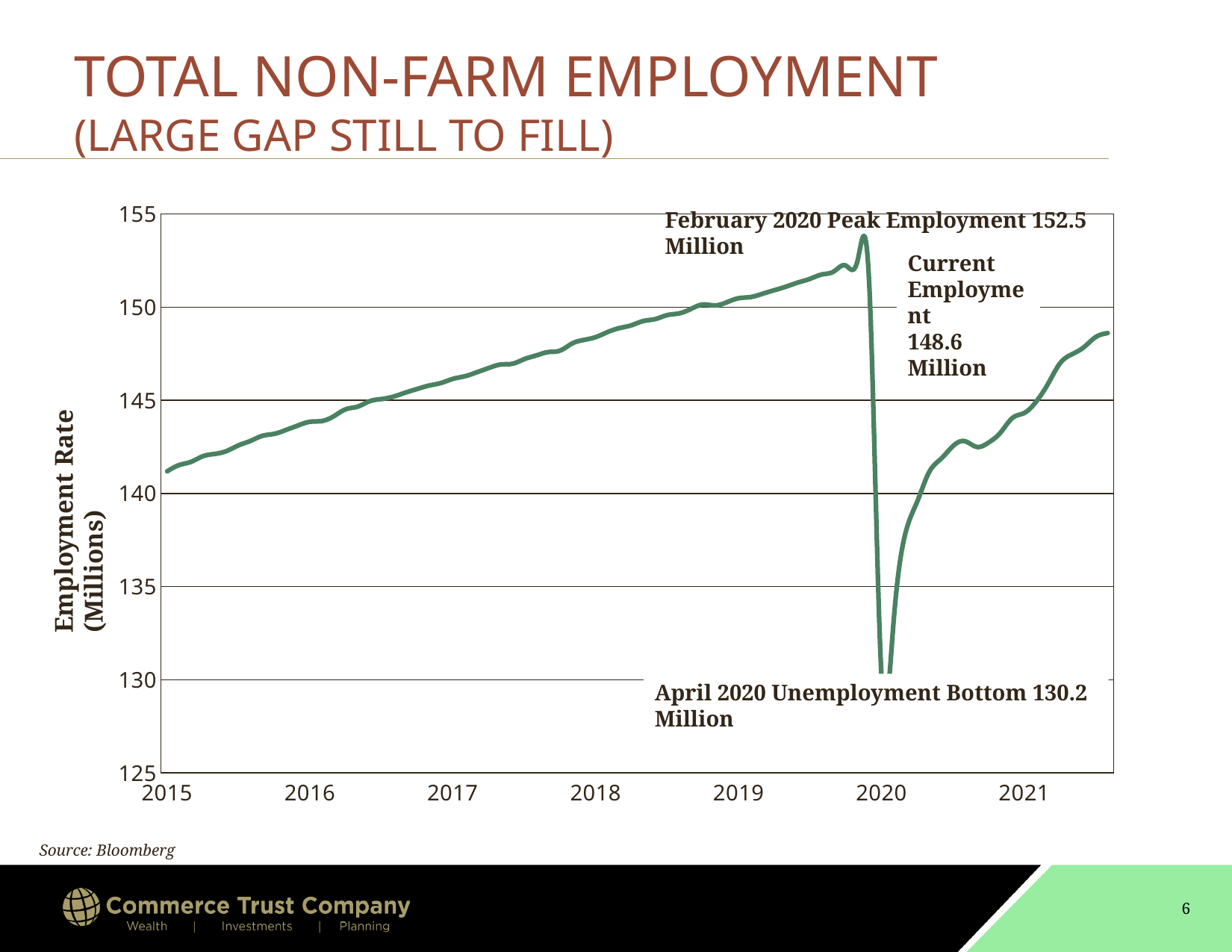
Is the employment value at the start of 2015 greater or less than 140? greater Which is larger, the February 2020 peak employment or the current employment? February 2020 peak employment What was the April 2020 bottom value according to the chart annotation? 130.2 Million How much lower is current employment (148.6 Million) than the February 2020 peak (152.5 Million)? 3.9 Million What is the difference between the February 2020 peak (152.5 Million) and the April 2020 bottom (130.2 Million)? 22.3 Million Does employment rise or fall between 2015 and early 2020? Rise What is the current employment value labelled on the chart? 148.6 Million What kind of chart is shown on the slide? Line chart What was the February 2020 peak employment according to the chart annotation? 152.5 Million Is the employment value at the start of 2018 greater or less than 145? greater How many year labels are shown on the x axis? 7 What is the label on the y axis of the chart? Employment Rate (Millions)